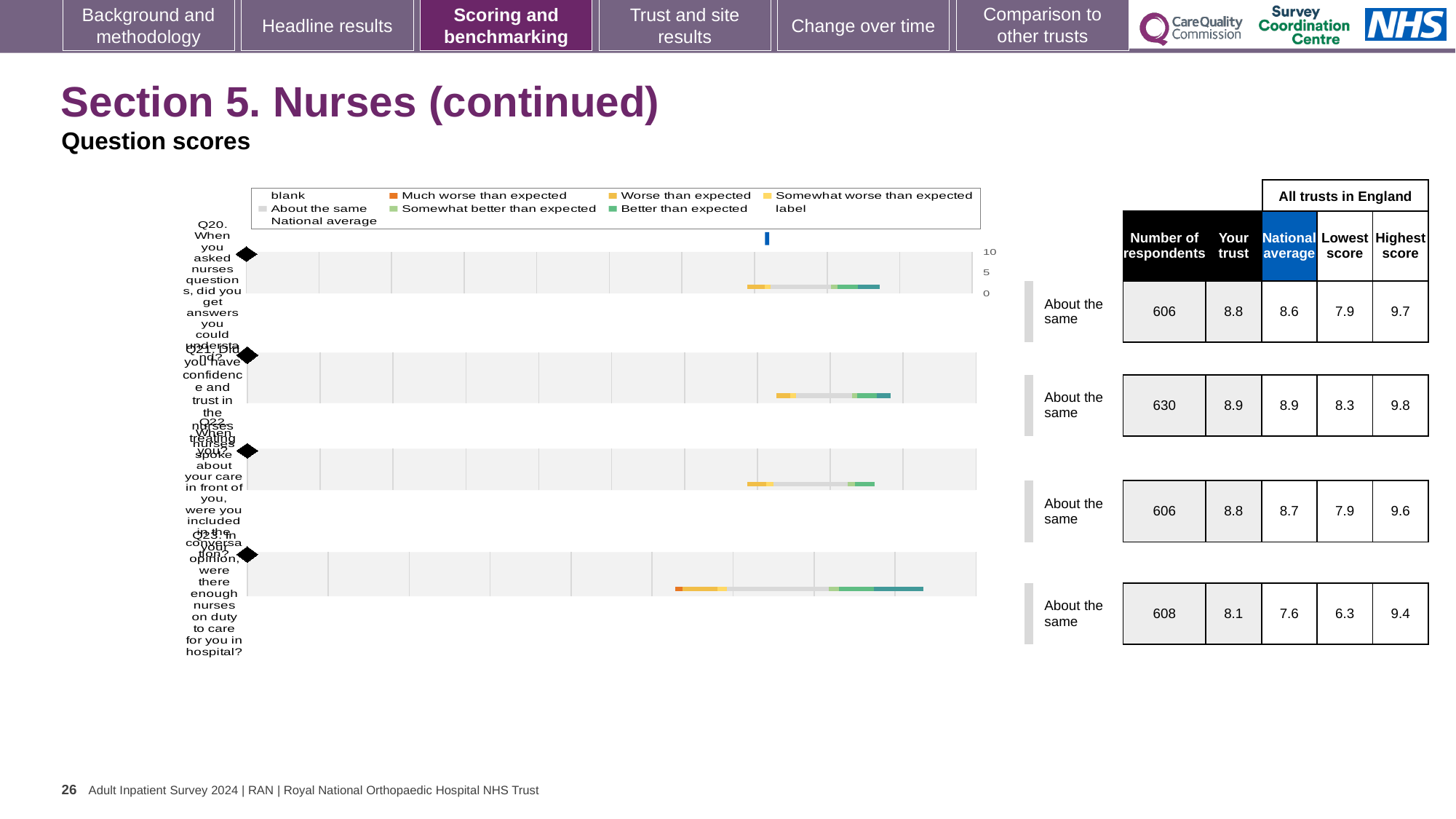
What is the maximum value shown on the score axis of the Q20 chart? 10 What kind of chart is used to show the question scores for Q20 to Q23? bar chart Which question has the lowest 'Your trust' score? Q23 For Q23, which is larger: the 'Your trust' score or the national average? Your trust Which question has the highest 'Your trust' score? Q21 What is the lowest score across all trusts in England for Q21? 8.3 How many question charts (Q20 to Q23) are shown on the slide? 4 What is the national average score for Q23 (In your opinion, were there enough nurses on duty to care for you in hospital)? 7.6 What benchmark category is shown for Q22 (When nurses spoke about your care in front of you, were you included in the conversation)? About the same What is the 'Your trust' score for Q20 (When you asked nurses questions, did you get answers you could understand)? 8.8 For Q23, what is the difference between the highest score and the lowest score across all trusts in England? 3.1 How many respondents answered Q21 (Did you have confidence and trust in the nurses treating you)? 630